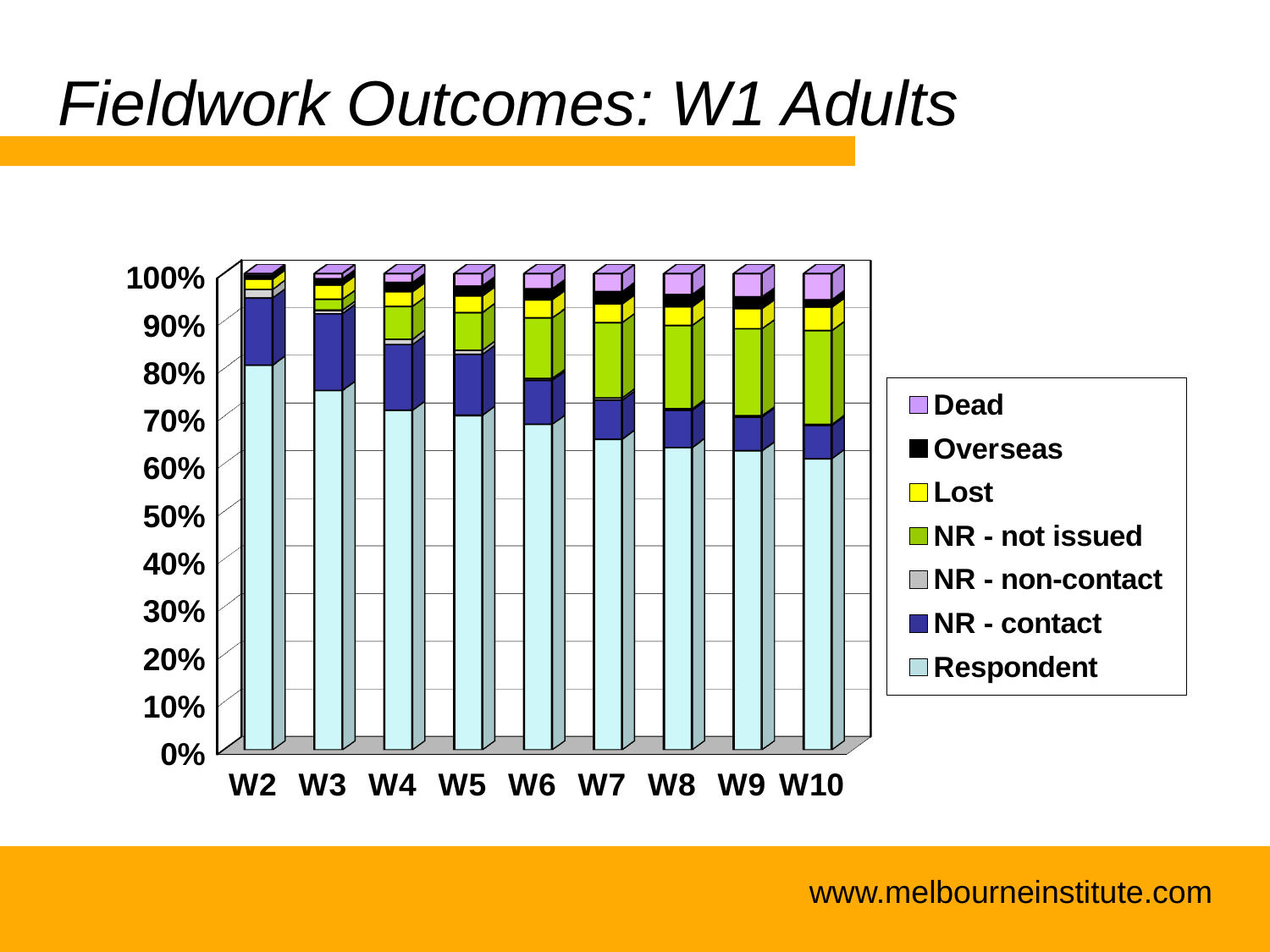
Which wave has the largest Respondent share? W2 Which wave has the smallest Respondent share? W10 Which wave has the larger Respondent share, W3 or W9? W3 How many waves (categories) are shown on the x axis? 9 Is the Respondent share for W10 greater or less than 70%? less Is the Respondent share for W6 greater or less than 80%? less What is the title of the slide's chart? Fieldwork Outcomes: W1 Adults What kind of chart is shown on the slide? Stacked bar chart Which legend entry is listed first, at the top of the legend? Dead Is the Respondent share for W2 greater or less than 70%? greater Does the Respondent share rise or fall from W2 to W10? Fall How many series does the legend list? 7